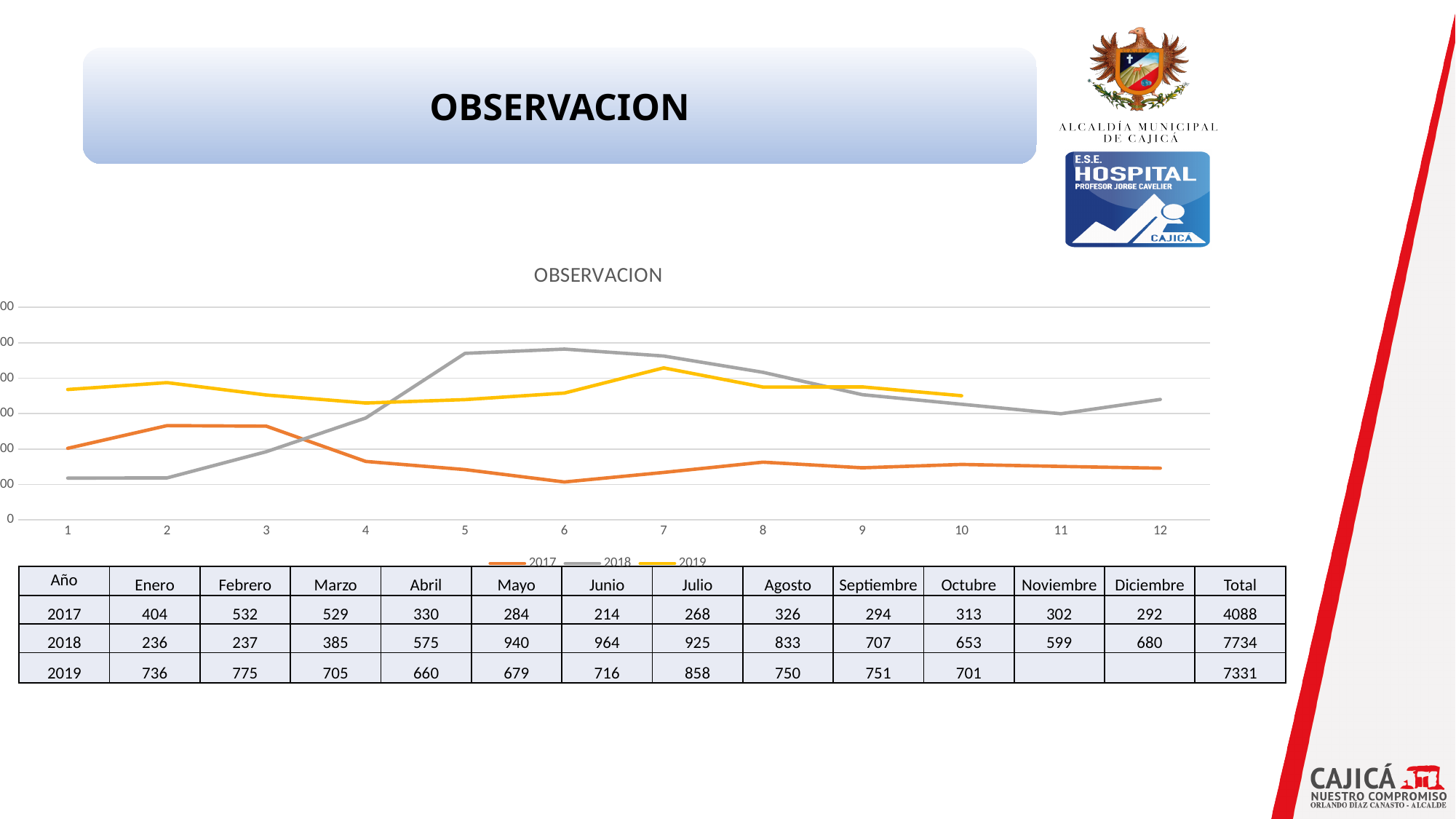
What is the value of the 2019 series at point 7 (Julio)? 858 What is the difference between the 2018 and 2017 values at point 6 (Junio)? 750 What kind of chart is shown on the slide? line chart What is the value of the 2018 series at point 6 (Junio)? 964 At point 1, which series has the larger value, 2017 or 2019? 2019 How many series does the chart legend list? 3 How many points are on the x axis of the chart? 12 Does the 2017 series rise or fall from point 3 to point 6? fall Which colour is used for the 2018 series in the chart? grey At which point does the 2017 series reach its lowest value? 6 (Junio) Which series has the highest value at point 5? 2018 What is the total for the 2018 series shown in the table? 7734